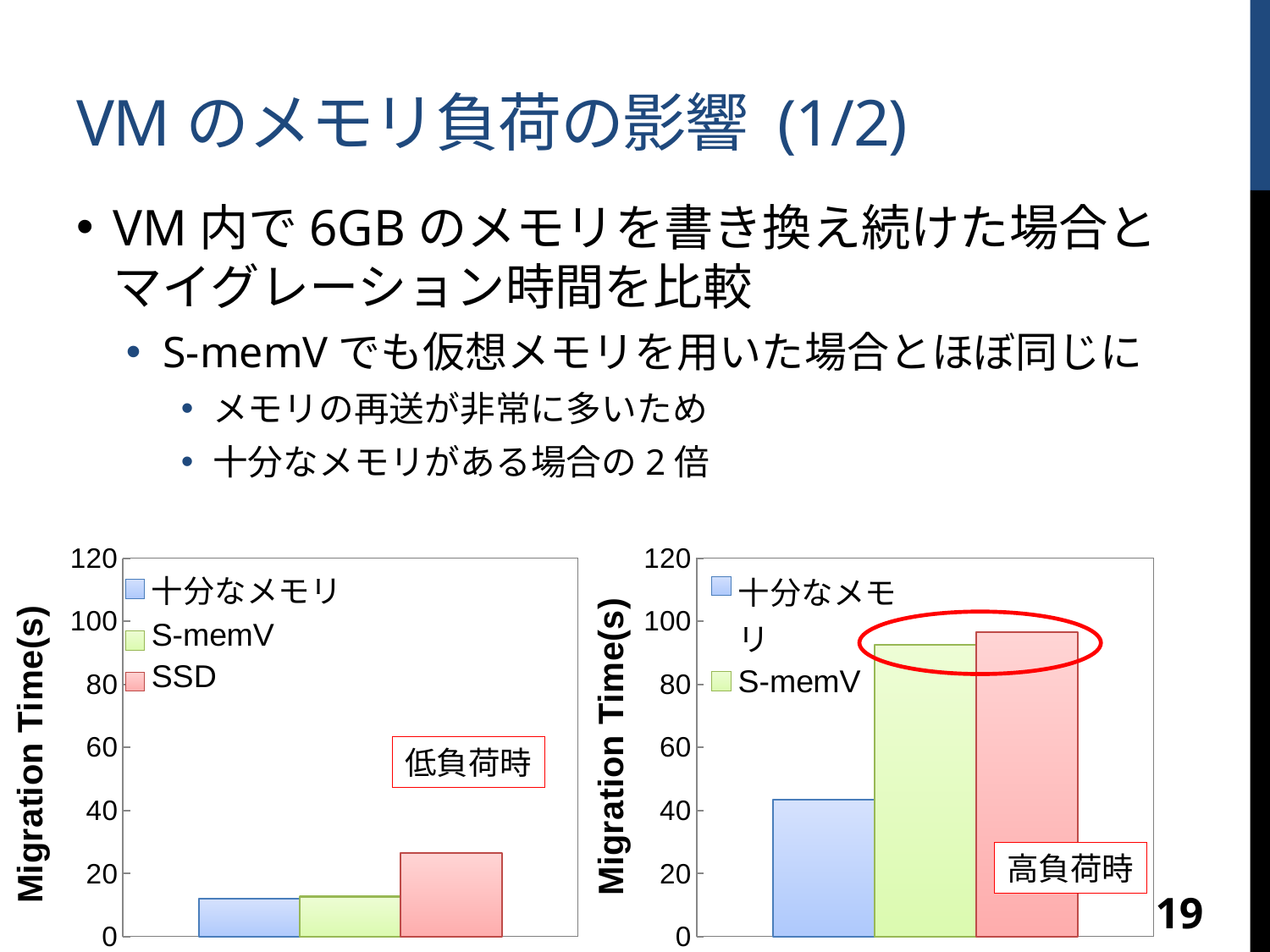
In the left chart (低負荷時), is the value for S-memV greater or less than 40? less What is the y-axis label of the right chart (高負荷時)? Migration Time(s) What is the maximum value shown on the y-axis of the left chart (低負荷時)? 120 How many series does the legend of the left chart (低負荷時) list? 3 What type of chart is the left chart labelled 低負荷時? bar chart In the left chart (低負荷時), is the value for SSD greater or less than 20? greater In the right chart (高負荷時), which is larger, the value for 十分なメモリ or the value for S-memV? S-memV In the left chart (低負荷時), is the value for 十分なメモリ greater or less than 20? less In the right chart (高負荷時), which series has the lowest migration time? 十分なメモリ In the left chart (低負荷時), which series has the highest migration time? SSD